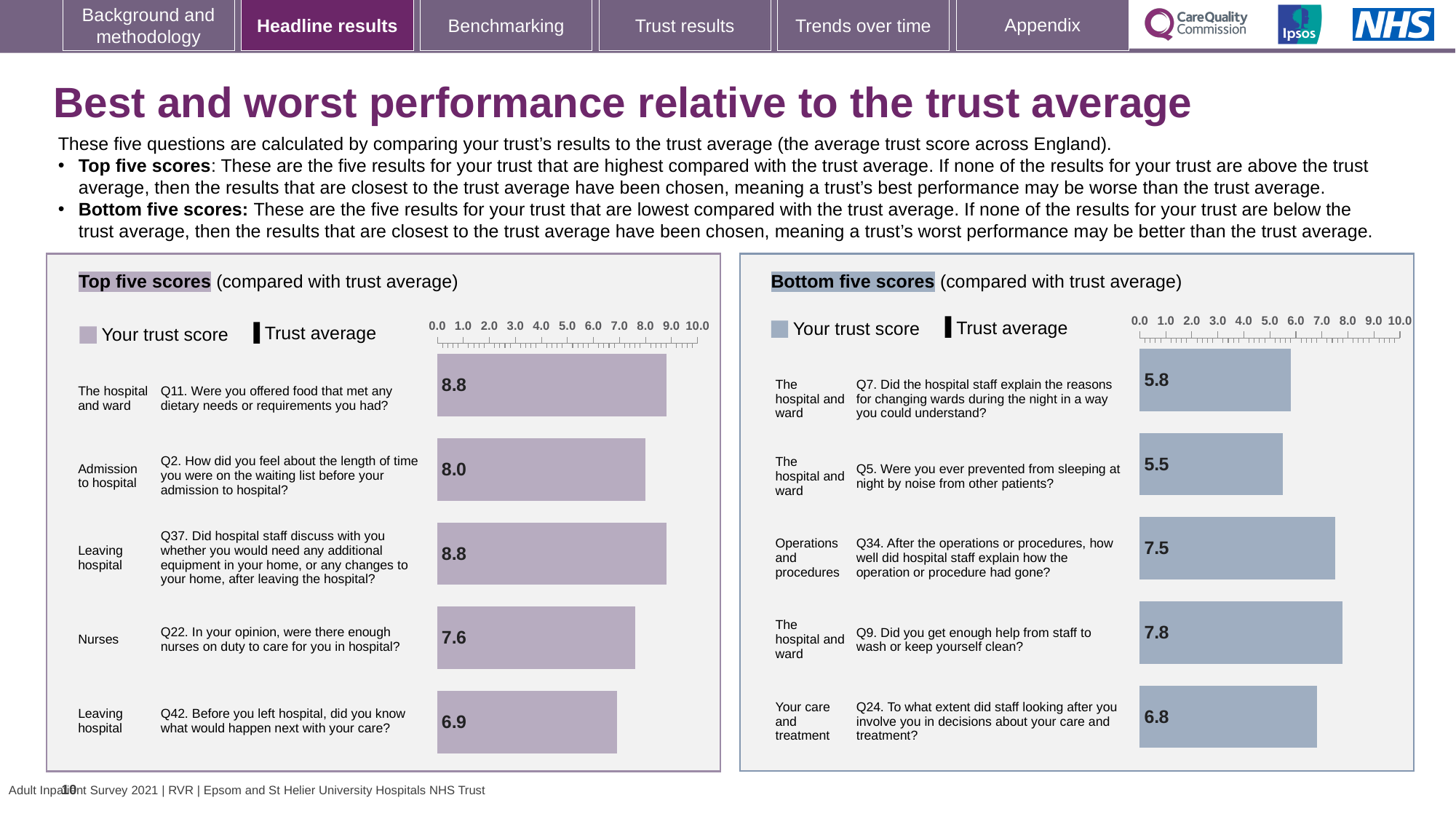
In the Bottom five scores chart, which question has the lowest trust score? Q5 In the Bottom five scores chart, what is the trust score for Q24 about involving you in decisions about your care and treatment? 6.8 In the Bottom five scores chart, what is the trust score for Q5 (Were you ever prevented from sleeping at night by noise from other patients?)? 5.5 What kind of chart is the Top five scores chart? Bar chart In the Bottom five scores chart, which question has the highest trust score? Q9 In the Top five scores chart, what is the trust score for Q22 about enough nurses on duty? 7.6 In the Bottom five scores chart, what is the difference between the scores for Q9 and Q5? 2.3 In the Top five scores chart, what is the difference between the scores for Q2 and Q42? 1.1 In the Bottom five scores chart, which has the higher score, Q34 or Q24? Q34 In the Top five scores chart, which question has the lowest trust score? Q42 In the Top five scores chart, what is the trust score for Q11 (Were you offered food that met any dietary needs or requirements you had?)? 8.8 How many questions are shown in the Bottom five scores chart? 5